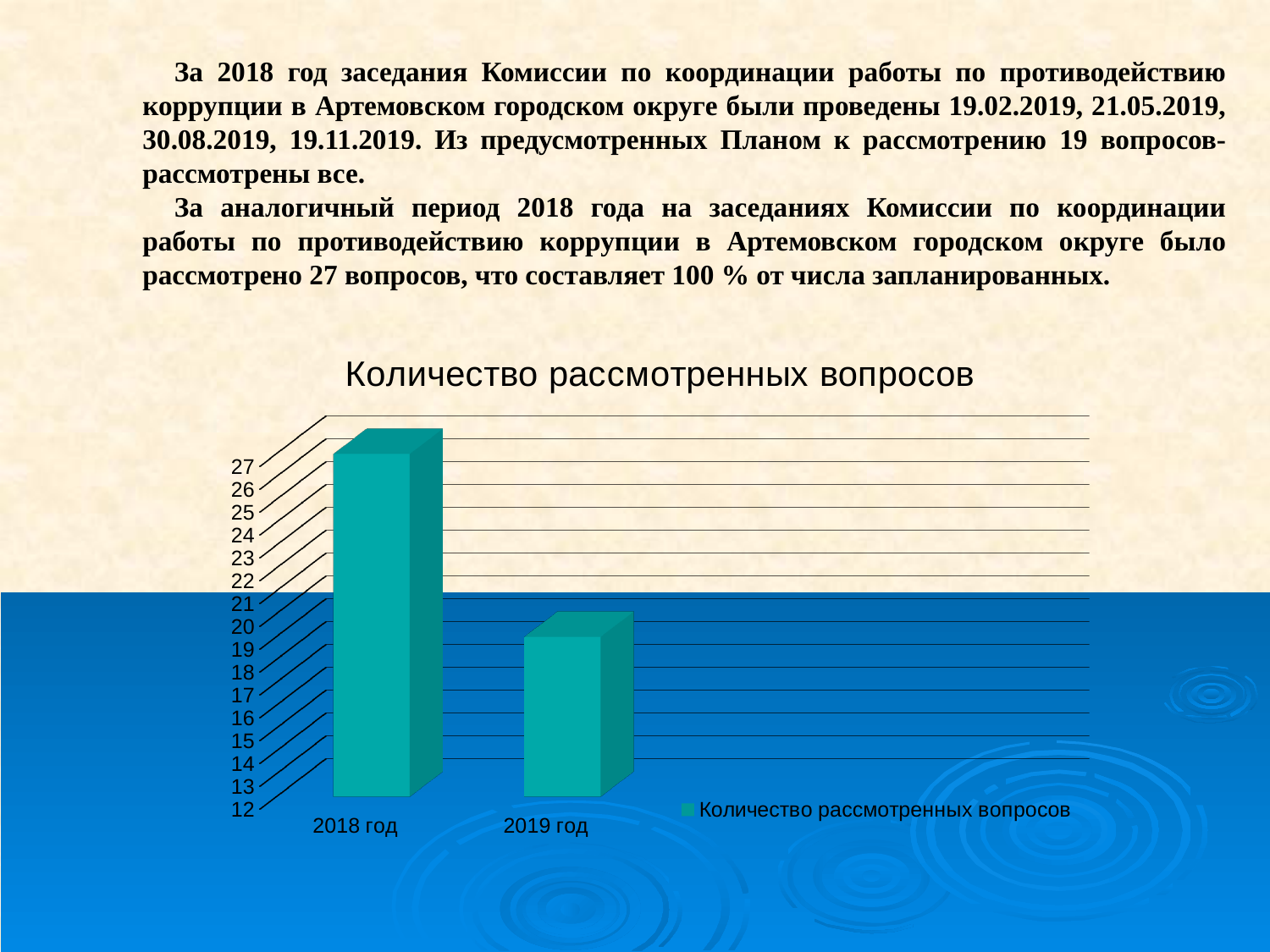
Is the value for 2019 год greater or less than 22? less Which category has the lowest value in the chart? 2019 год What is the value for 2018 год in the chart? 27 Do the values rise or fall from 2018 год to 2019 год? fall How many categories are shown on the x axis of the chart? 2 Which is larger, the value for 2018 год or the value for 2019 год? 2018 год What kind of chart is shown on the slide? bar chart What is the difference between the values for 2018 год and 2019 год? 8 How many series does the chart legend list? 1 What is the title of the chart? Количество рассмотренных вопросов What is the value for 2019 год in the chart? 19 Which category has the highest value in the chart? 2018 год